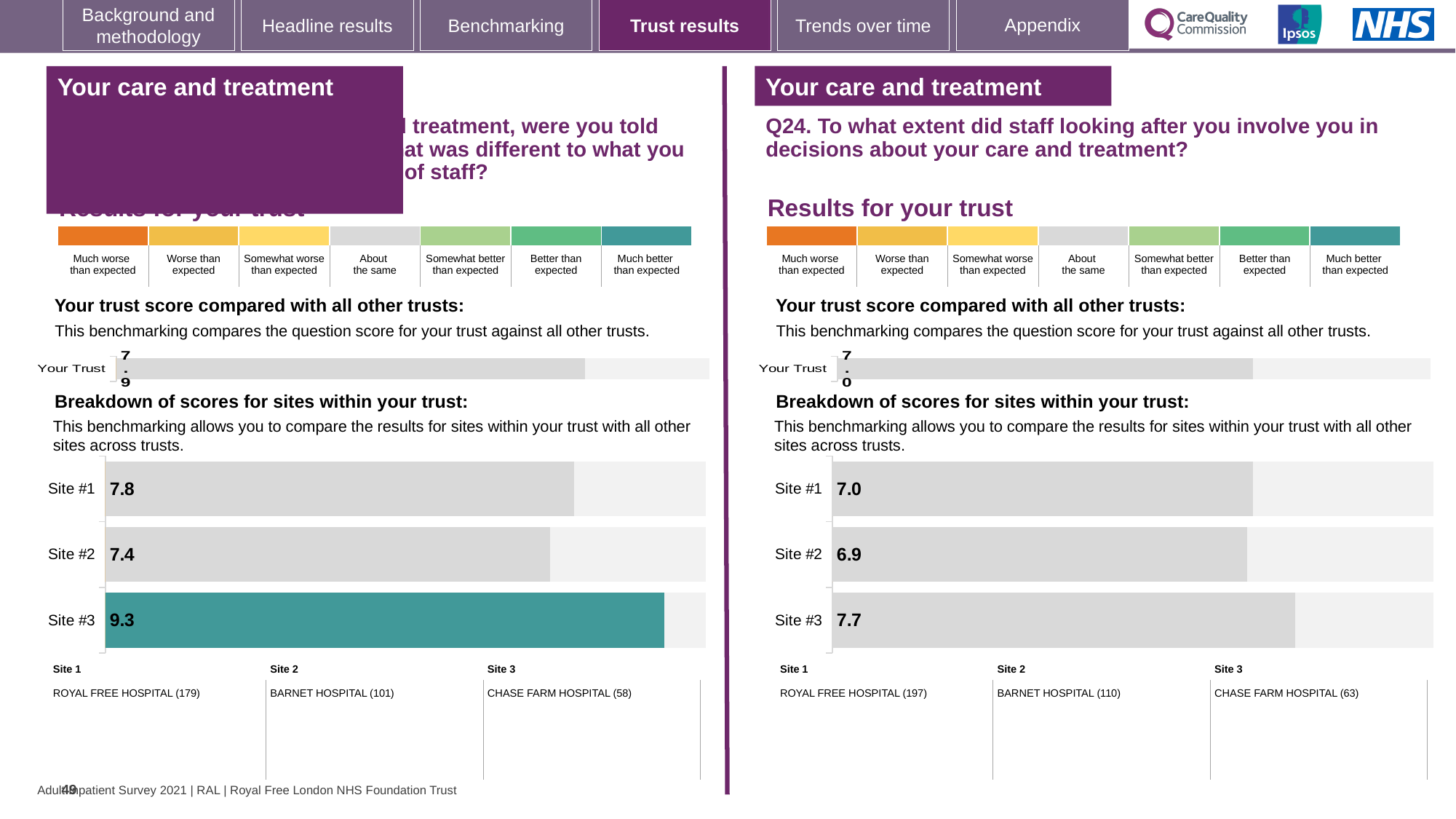
In the right-hand (Q24) site breakdown chart, what is the score for Site #1? 7.0 In the left-hand site breakdown chart, which site has the highest score? Site #3 What type of chart is used for the site breakdown on the right-hand (Q24) panel? Bar chart In the right-hand (Q24) site breakdown chart, what is the difference between the scores for Site #3 and Site #2? 0.8 In the right-hand (Q24) site breakdown chart, which site has the lowest score? Site #2 In the left-hand site breakdown chart, what is the difference between the scores for Site #3 and Site #1? 1.5 How many sites are shown in the left-hand site breakdown chart? 3 In the right-hand (Q24) site breakdown chart, which has the larger score, Site #1 or Site #3? Site #3 In the left-hand site breakdown chart, what is the score for Site #2? 7.4 In the left-hand site breakdown chart, what is the score for Site #3? 9.3 In the left-hand site breakdown chart, which site's bar is coloured teal rather than grey? Site #3 In the right-hand (Q24) site breakdown chart, what is the score for Site #3? 7.7